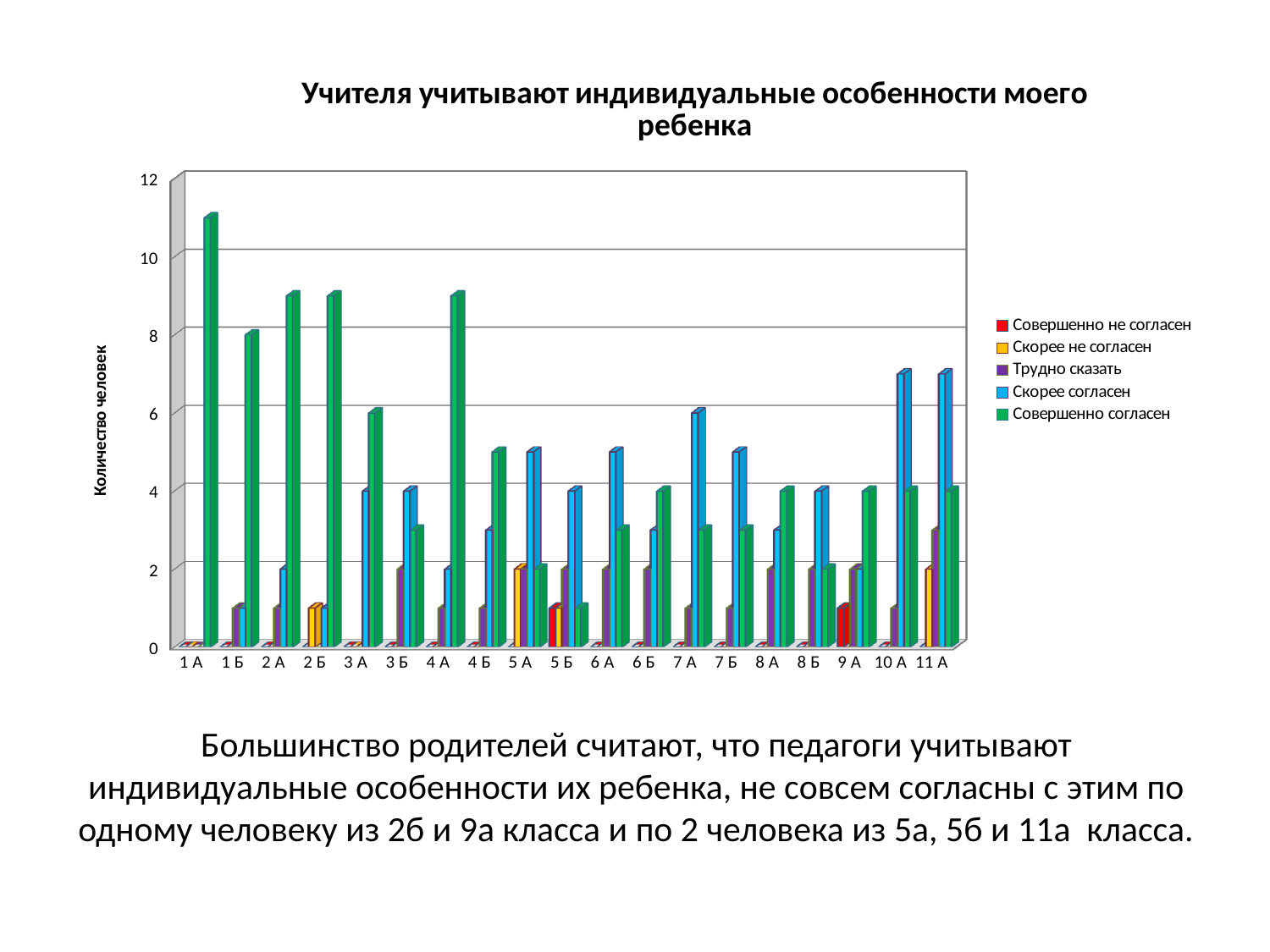
Which class has the highest value for the series "Совершенно согласен"? 1 А Which is larger for class 7 А: the value for "Скорее согласен" or the value for "Совершенно согласен"? Скорее согласен Which class has the larger value for "Совершенно согласен": 1 А or 1 Б? 1 А Is the value for "Скорее согласен" in class 10 А greater or less than 6? greater What is the label of the vertical axis? Количество человек What kind of chart is shown on the slide? bar chart How many series does the legend list? 5 Is the value for "Совершенно не согласен" in class 9 А greater or less than 2? less Is the value for "Совершенно согласен" in class 1 А greater or less than 10? greater What is the title of the chart? Учителя учитывают индивидуальные особенности моего ребенка How many classes (categories) are shown along the x axis? 19